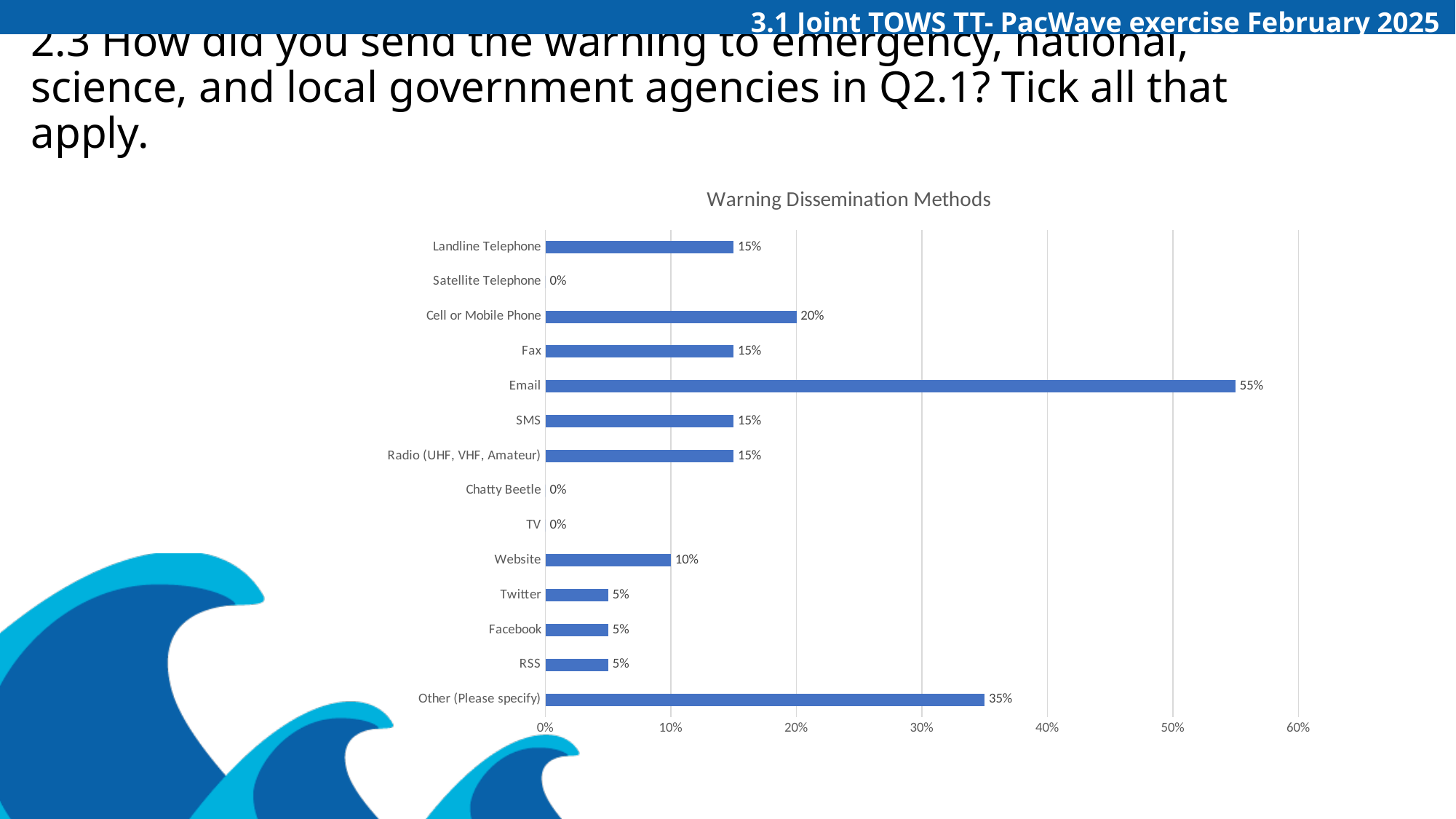
What is the title of the chart? Warning Dissemination Methods What is the value for Email? 55% What is the value for Website? 10% What is the difference between the values for Email and Other (Please specify)? 20% What is the value for Other (Please specify)? 35% Which is larger, the value for Cell or Mobile Phone or the value for Website? Cell or Mobile Phone What is the value for Cell or Mobile Phone? 20% Is the value for Email greater or less than 50%? greater How many categories have a value of 0%? 3 Which category has the highest value? Email What kind of chart is shown? bar chart How many categories are shown on the chart? 14